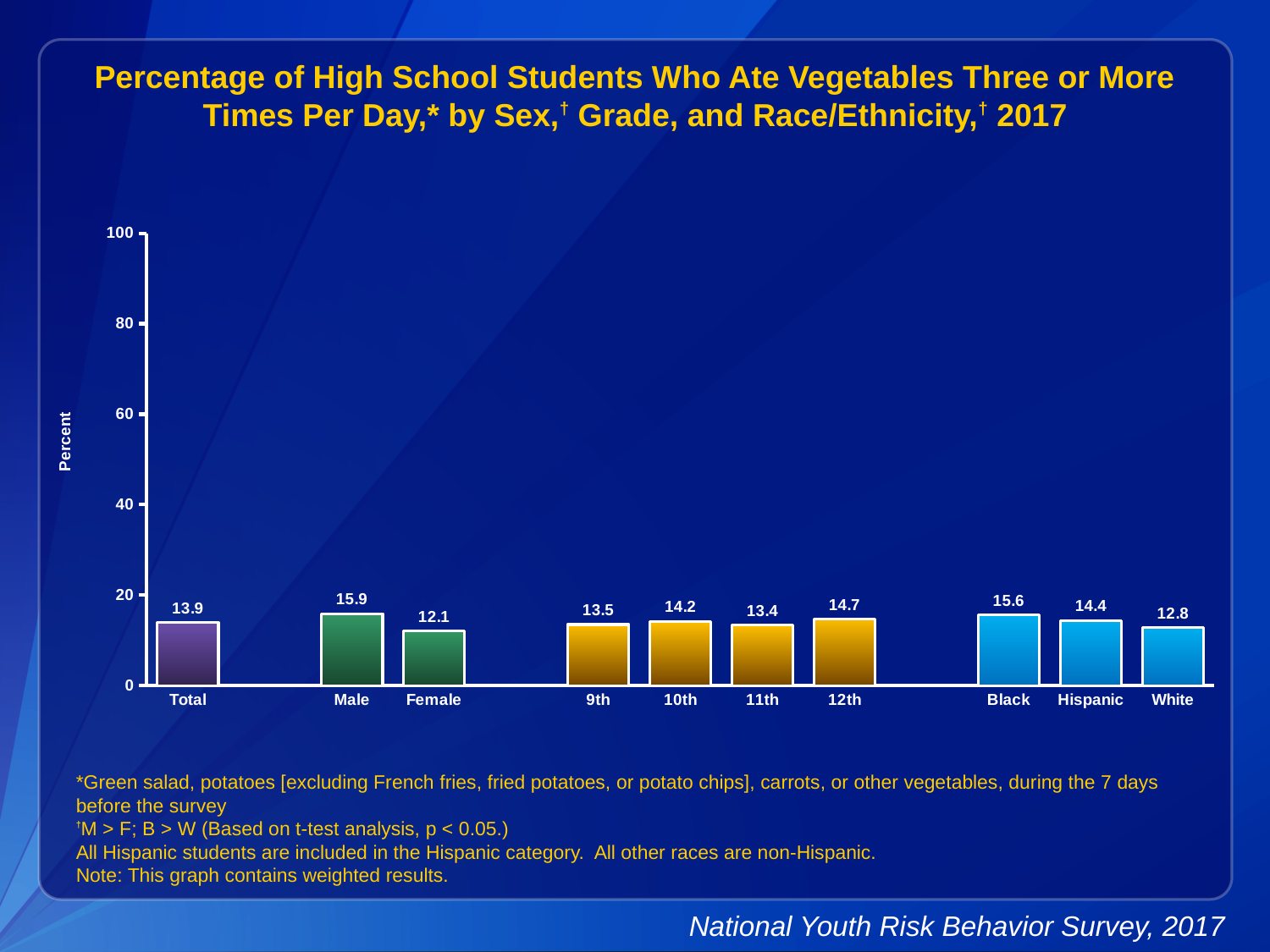
Which category has the highest value? Male How many categories are shown on the x axis? 10 What is the difference between the Male and Female values? 3.8 Which is larger, the value for 10th grade or 11th grade? 10th Which category has the lowest value? Female What is the value for 12th grade? 14.7 What is the value for Total? 13.9 What kind of chart is this? Bar chart What percentage of female students ate vegetables three or more times per day? 12.1 What is the value for Hispanic students? 14.4 What is the difference between the Black and White values? 2.8 Is the value for Black students greater or less than 20? less